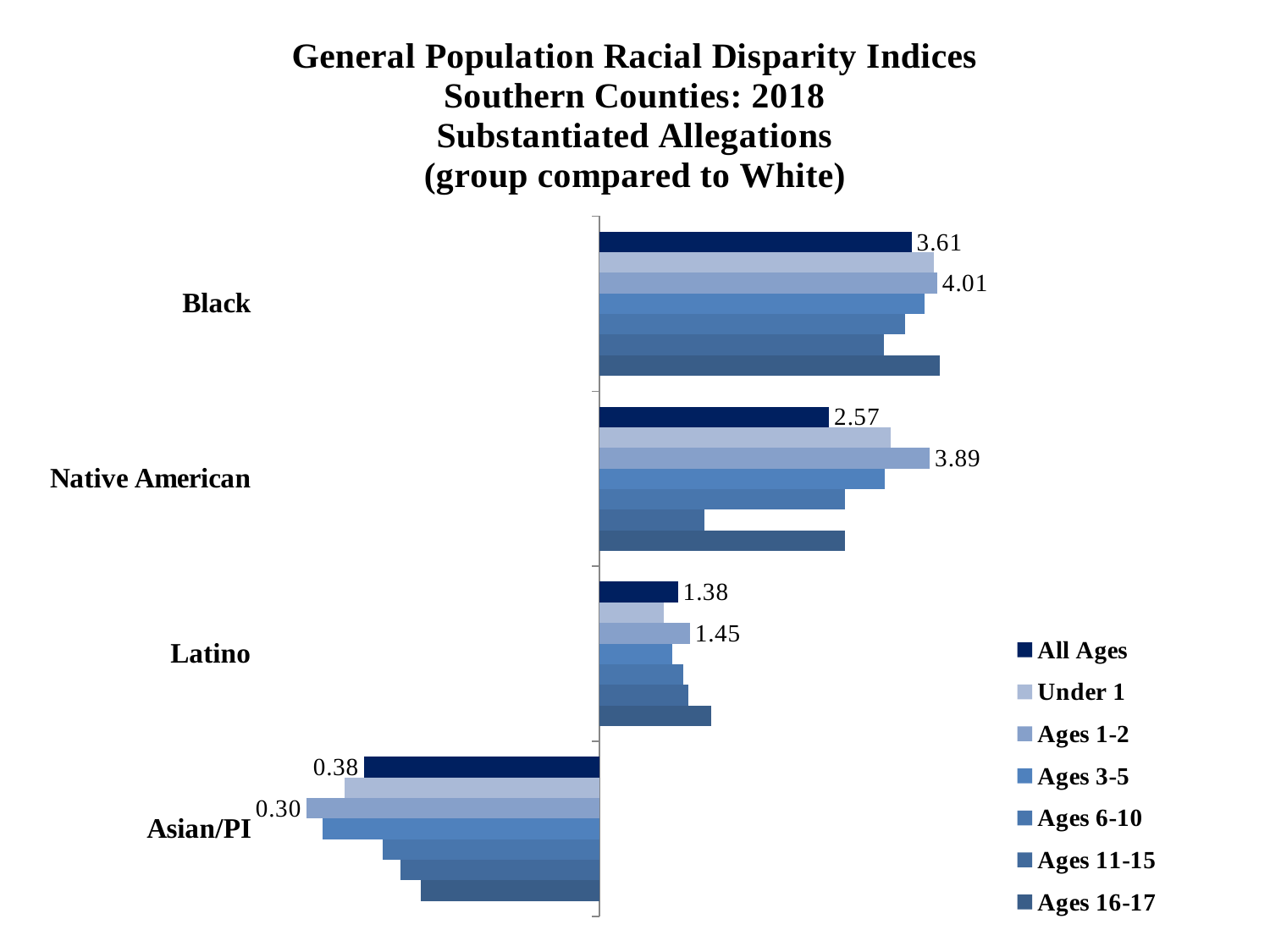
Which racial group has the lowest All Ages disparity index? Asian/PI What is the Ages 1-2 disparity index for Asian/PI? 0.30 What is the All Ages disparity index for Native American? 2.57 What is the All Ages disparity index for Black? 3.61 Which racial group has the highest All Ages disparity index? Black What is the All Ages disparity index for Asian/PI? 0.38 What is the difference between the All Ages disparity index for Black and for Native American? 1.04 How many racial groups are shown on the chart? 4 How many age-group series does the legend list? 7 What is the Ages 1-2 disparity index for Native American? 3.89 For Latino, which is larger: the All Ages index or the Ages 1-2 index? Ages 1-2 What is the Ages 1-2 disparity index for Black? 4.01